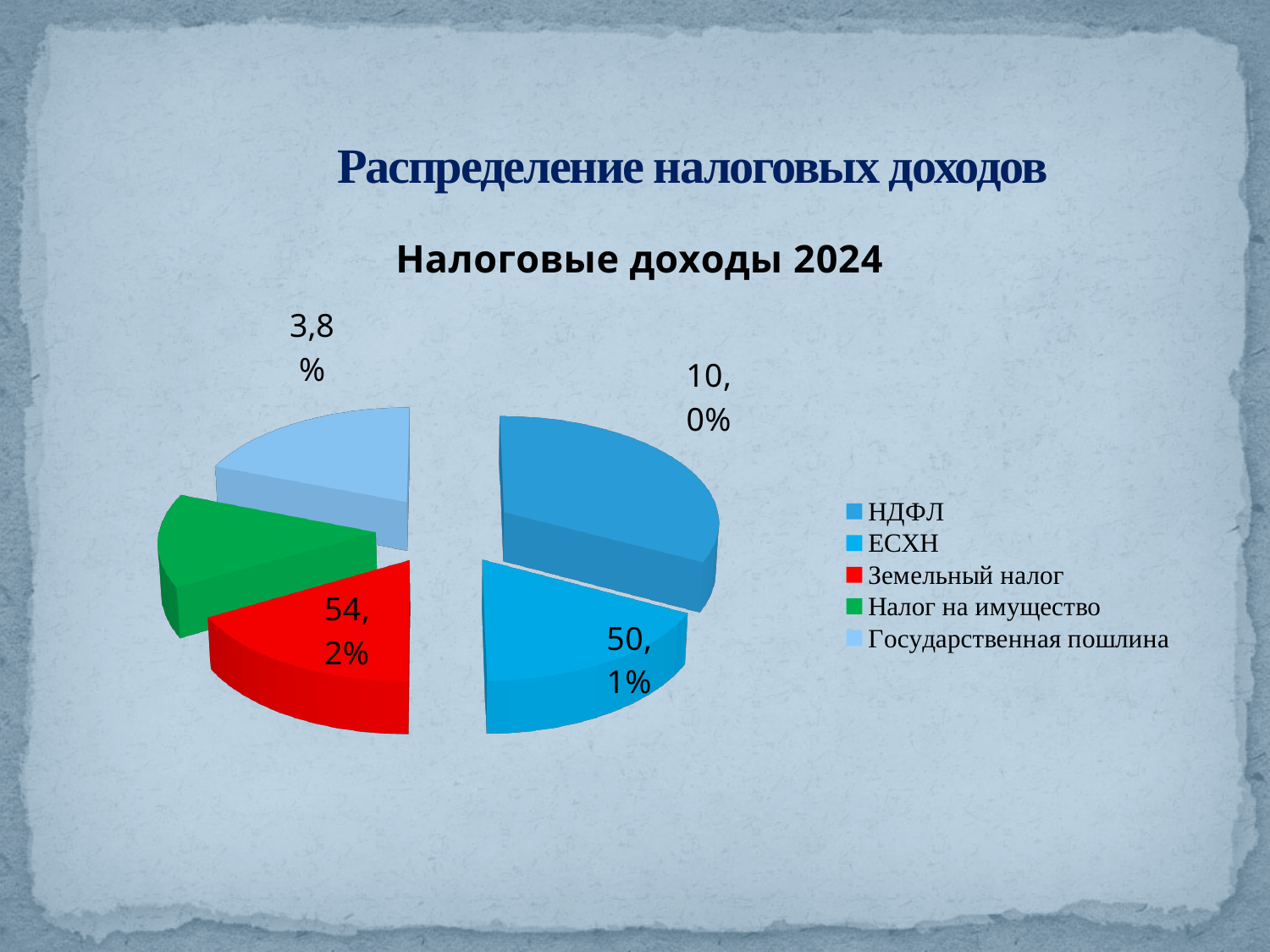
According to the printed labels, which is larger: Земельный налог or ЕСХН? Земельный налог Which category is shown in red on the chart? Земельный налог Which category's slice is labelled 3,8%? Государственная пошлина What percentage is shown for НДФЛ? 10,0% What percentage is shown for Земельный налог? 54,2% What percentage is shown for ЕСХН? 50,1% What is the title of the chart? Налоговые доходы 2024 What type of chart is shown on the slide? pie chart What is the difference between the printed values for Земельный налог and ЕСХН? 4,1% How many categories does the legend of the chart list? 5 What percentage is shown for Государственная пошлина? 3,8%